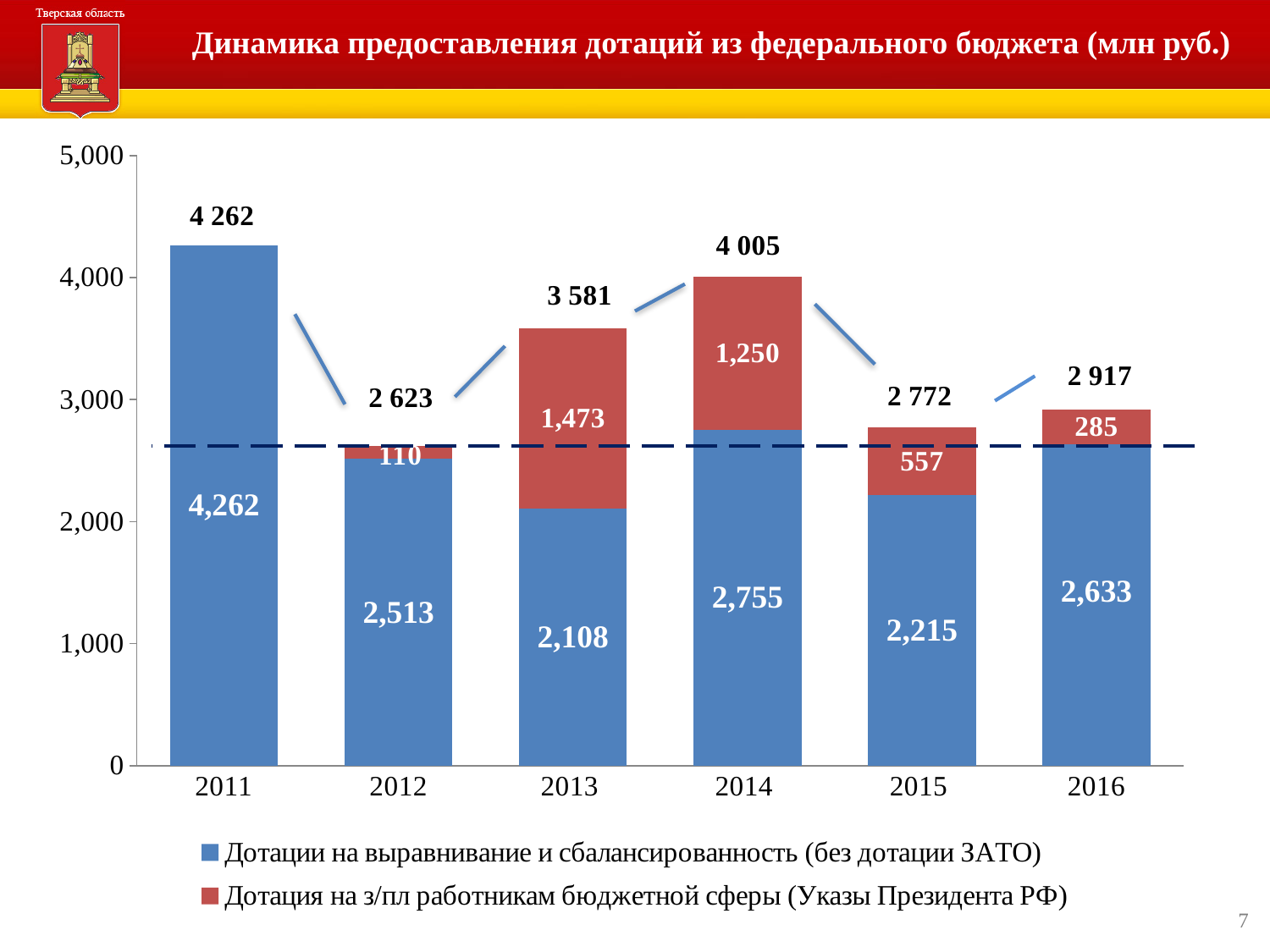
What is the difference between the total for 2014 and the total for 2013? 424 What colour represents 'Дотация на з/пл работникам бюджетной сферы (Указы Президента РФ)' in the chart? red Which year has the lowest total dotation? 2012 What type of chart is shown on the slide? stacked bar chart Which year has the highest total dotation? 2011 How many years are shown on the x axis of the chart? 6 Is the total for 2016 greater or less than 3,000? less Which is larger: the 'Дотация на з/пл работникам бюджетной сферы' value for 2013 or for 2015? 2013 What is the value of 'Дотации на выравнивание и сбалансированность (без дотации ЗАТО)' for 2013? 2,108 How many series does the legend list? 2 What is the value of 'Дотация на з/пл работникам бюджетной сферы (Указы Президента РФ)' for 2014? 1,250 What is the total of the stacked bar for 2015? 2 772